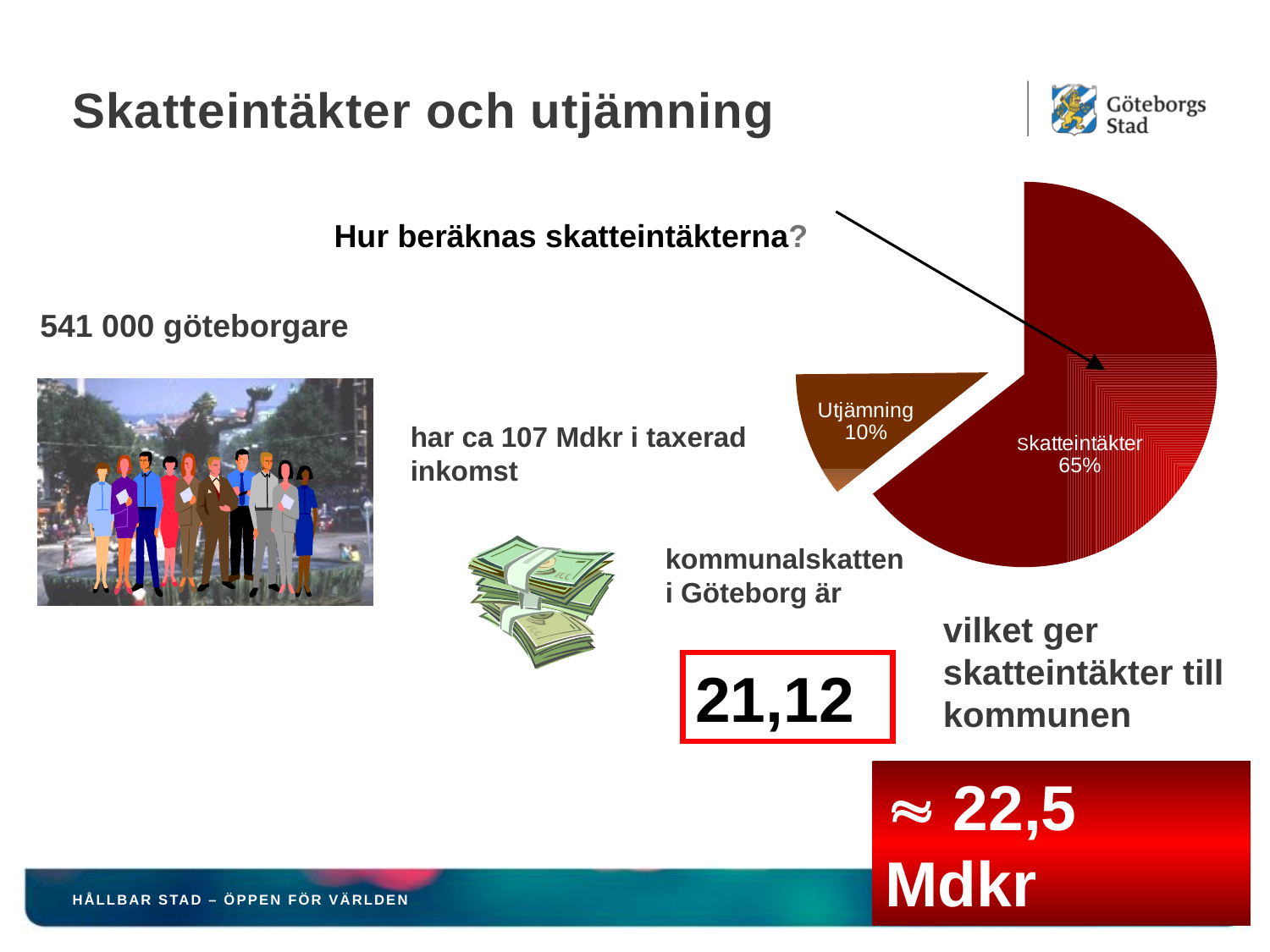
Which labeled slice of the pie chart is the largest? Skatteintäkter What is the difference in percentage points between the Skatteintäkter slice and the Utjämning slice? 55 percentage points What colour is the Skatteintäkter slice of the pie chart? Dark red What kind of chart is shown on the slide? Pie chart Is the Utjämning slice greater or less than 50% of the pie? less What percentage does the Skatteintäkter slice of the pie chart represent? 65% What share of the pie does the Skatteintäkter slice take? 65% How many labeled slices does the pie chart have? 2 Which is larger in the pie chart, Skatteintäkter or Utjämning? Skatteintäkter What percentage does the Utjämning slice of the pie chart represent? 10% Which labeled slice of the pie chart is the smallest? Utjämning What colour is the Utjämning slice of the pie chart? Brown